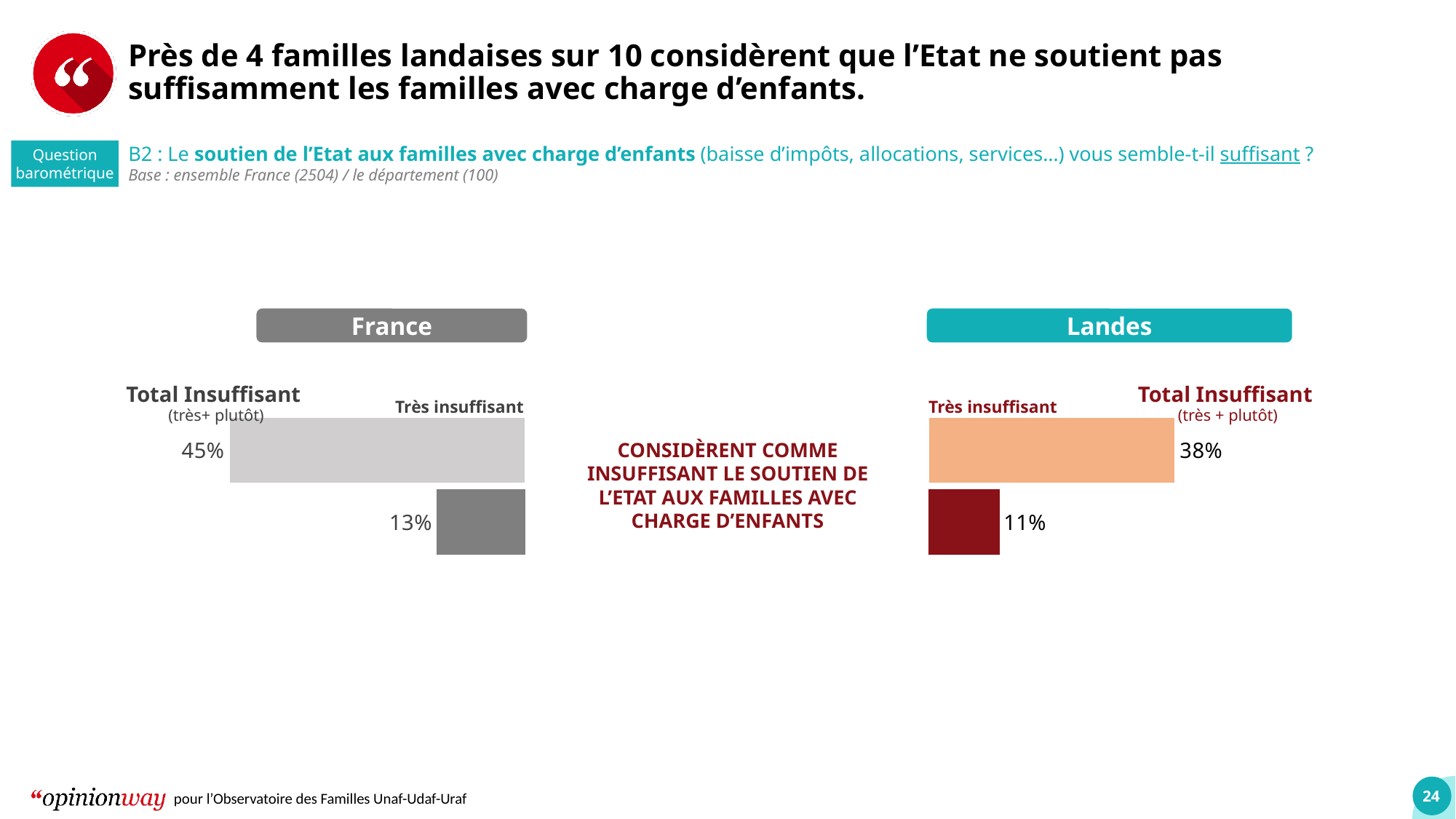
How many bars are shown in the Landes chart? 2 Which is larger, the Total Insuffisant value for France or for Landes? France What is the difference between the Très insuffisant values for France and Landes? 2 points In the France chart, what is the value for Très insuffisant? 13% What is the difference between the Total Insuffisant values for France and Landes? 7 points In the Landes chart, what is the value for Très insuffisant? 11% In the France chart, which category has the highest value? Total Insuffisant (très + plutôt) In the Landes chart, what is the value for Total Insuffisant (très + plutôt)? 38% Which is larger, the Très insuffisant value for France or for Landes? France In the France chart, what is the value for Total Insuffisant (très + plutôt)? 45% What kind of chart is used for the France data? Bar chart In the Landes chart, which category has the lowest value? Très insuffisant